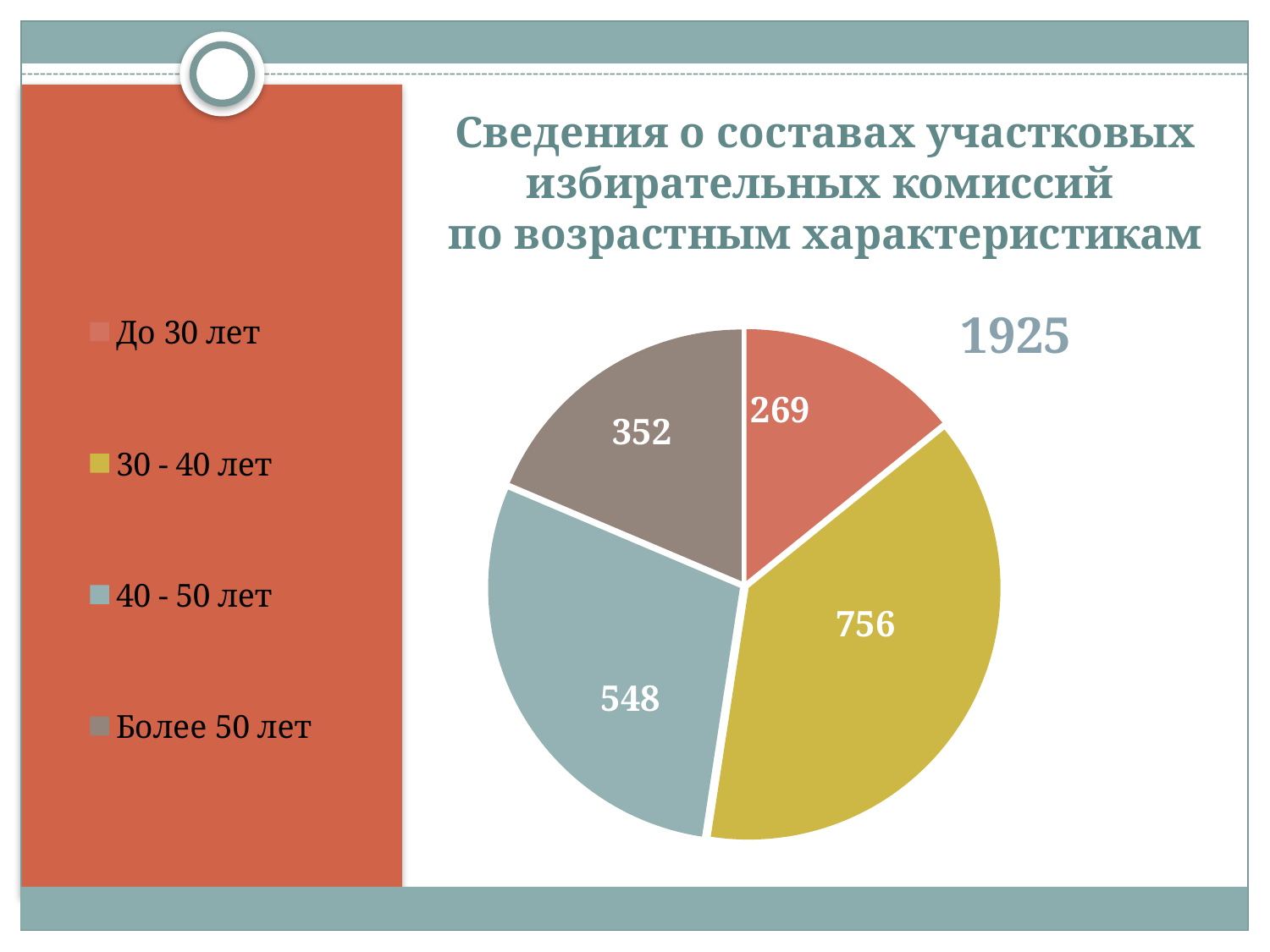
What is the value for the "До 30 лет" slice? 269 What is the difference between the values for "Более 50 лет" and "До 30 лет"? 83 How many slices does the pie chart have? 4 Which age group has the largest slice of the pie? 30 - 40 лет What is the value for the "Более 50 лет" slice? 352 What is the difference between the values for "30 - 40 лет" and "40 - 50 лет"? 208 Which is larger, the value for "40 - 50 лет" or the value for "Более 50 лет"? 40 - 50 лет What total number is printed next to the pie chart? 1925 What is the value for the "30 - 40 лет" slice? 756 Which age group has the smallest slice of the pie? До 30 лет What is the value for the "40 - 50 лет" slice? 548 What type of chart is shown on the slide? pie chart